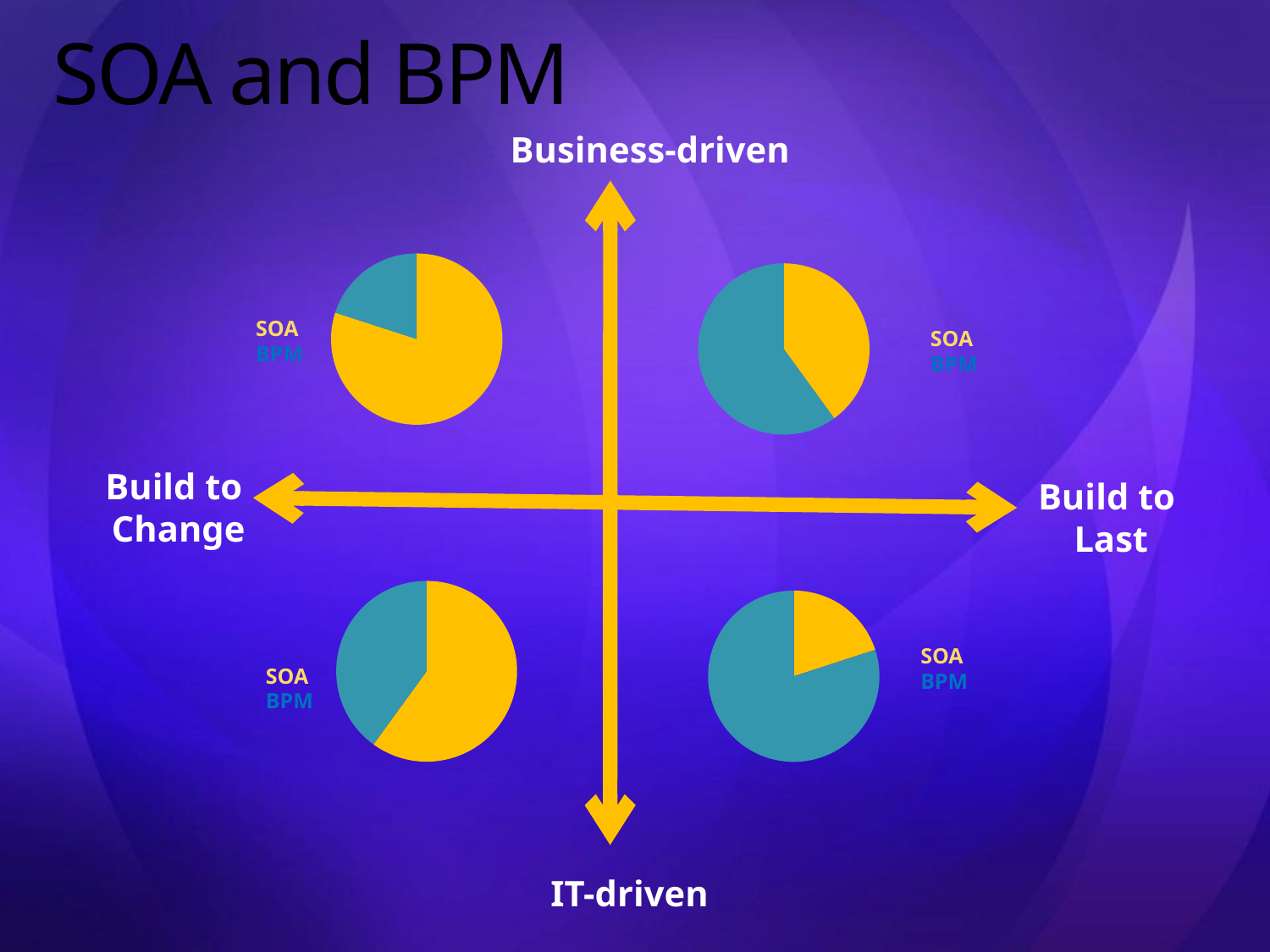
In the bottom-left pie chart (IT-driven, Build to Change), which slice is larger, SOA or BPM? SOA Which of the four pie charts has the smallest SOA slice? Bottom-right (IT-driven, Build to Last) How many pie charts are shown on the slide? 4 What kind of chart is shown in the top-left quadrant (Business-driven, Build to Change)? Pie chart How many slices does the pie chart in the bottom-right quadrant (IT-driven, Build to Last) have? 2 In the top-right pie chart (Business-driven, Build to Last), which slice is larger, SOA or BPM? BPM What are the two labels at the ends of the vertical axis on the slide? Business-driven and IT-driven In the bottom-right pie chart (IT-driven, Build to Last), which slice is larger, SOA or BPM? BPM Which of the four pie charts has the largest SOA slice? Top-left (Business-driven, Build to Change) What colour represents SOA in the pie charts? Yellow How many series does the legend next to each pie chart list? 2